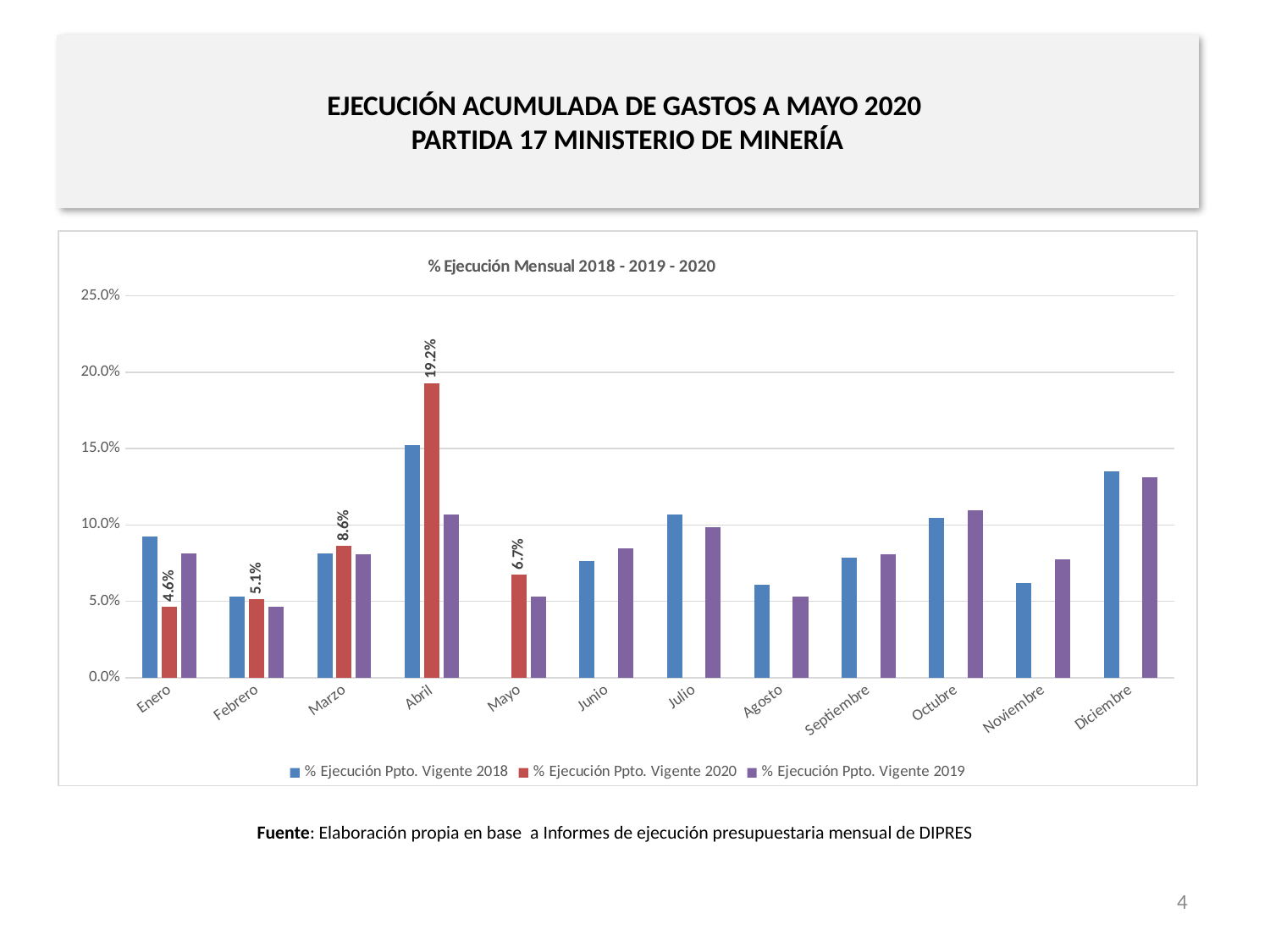
What is the difference between the 2020 values for Mayo and Enero? 2.1% How many months are shown on the x axis of the chart? 12 Is the value for % Ejecución Ppto. Vigente 2018 in Diciembre greater or less than 10.0%? greater What is the difference between the 2020 values for Abril and Marzo? 10.6% What is the value for % Ejecución Ppto. Vigente 2020 in Abril? 19.2% How many series does the legend list? 3 Is the value for % Ejecución Ppto. Vigente 2019 in Mayo greater or less than 10.0%? less What is the value for % Ejecución Ppto. Vigente 2020 in Enero? 4.6% In which month is the % Ejecución Ppto. Vigente 2020 value highest? Abril Which is larger for % Ejecución Ppto. Vigente 2020: Marzo or Febrero? Marzo In which month is the % Ejecución Ppto. Vigente 2020 value lowest? Enero What is the value for % Ejecución Ppto. Vigente 2020 in Mayo? 6.7%